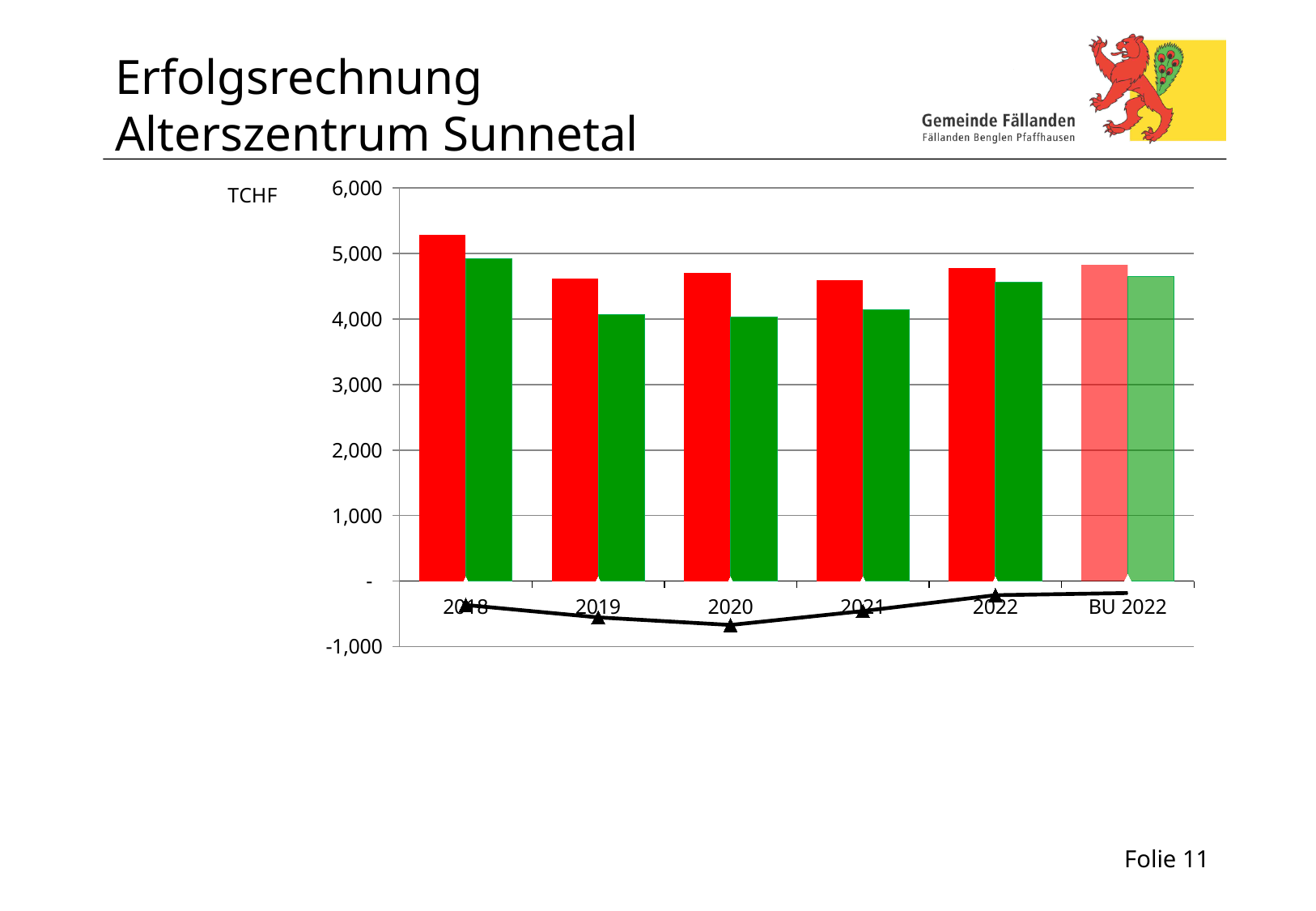
Is the red bar for 2018 greater or less than 5,000? greater In 2018, which is larger, the red bar or the green bar? The red bar Which category has the tallest green bar? 2018 Is the green bar for 2021 greater or less than 4,000? greater Which year has the tallest red bar? 2018 How many categories are shown on the x axis? 6 What unit label is shown next to the vertical axis? TCHF At which year does the black line reach its lowest point? 2020 What is the label of the last category on the x axis? BU 2022 What kind of chart is shown on the slide? Bar chart with a line Is the red bar for 2019 greater or less than 5,000? less Does the black line rise or fall from 2020 to BU 2022? Rise